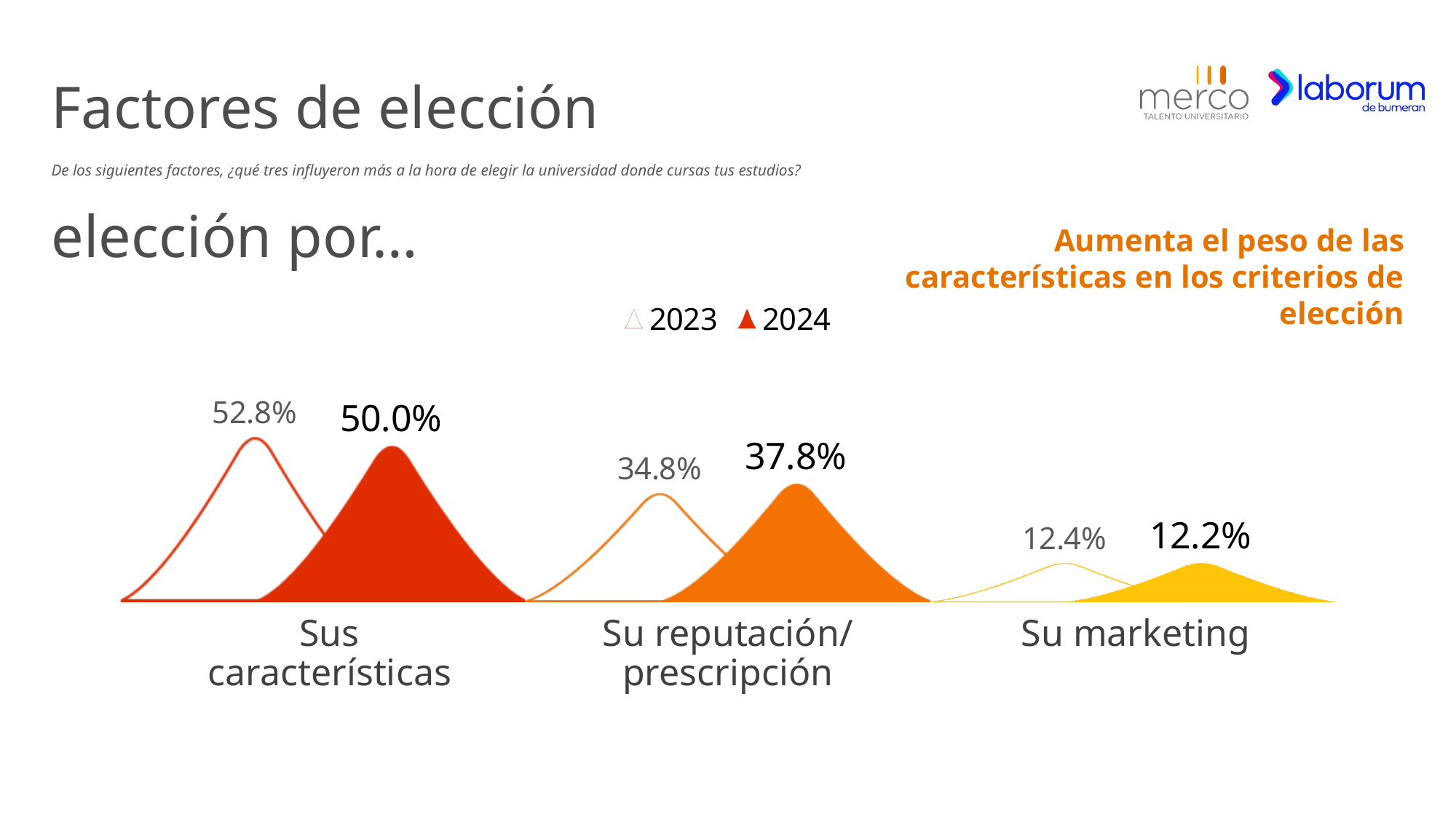
Which category has the highest 2024 value? Sus características Which category has the lowest 2023 value? Su marketing What is the difference between the 2023 and 2024 values for Sus características? 2.8% What is the 2023 value for Sus características? 52.8% What is the 2024 value for Sus características? 50.0% What is the 2024 value for Su marketing? 12.2% How many categories are shown on the x axis? 3 For Su reputación/prescripción, which year has the larger value, 2023 or 2024? 2024 How many series does the legend list? 2 What is the 2023 value for Su reputación/prescripción? 34.8% What is the difference between the 2023 and 2024 values for Su reputación/prescripción? 3.0% Which years are listed in the legend? 2023 and 2024